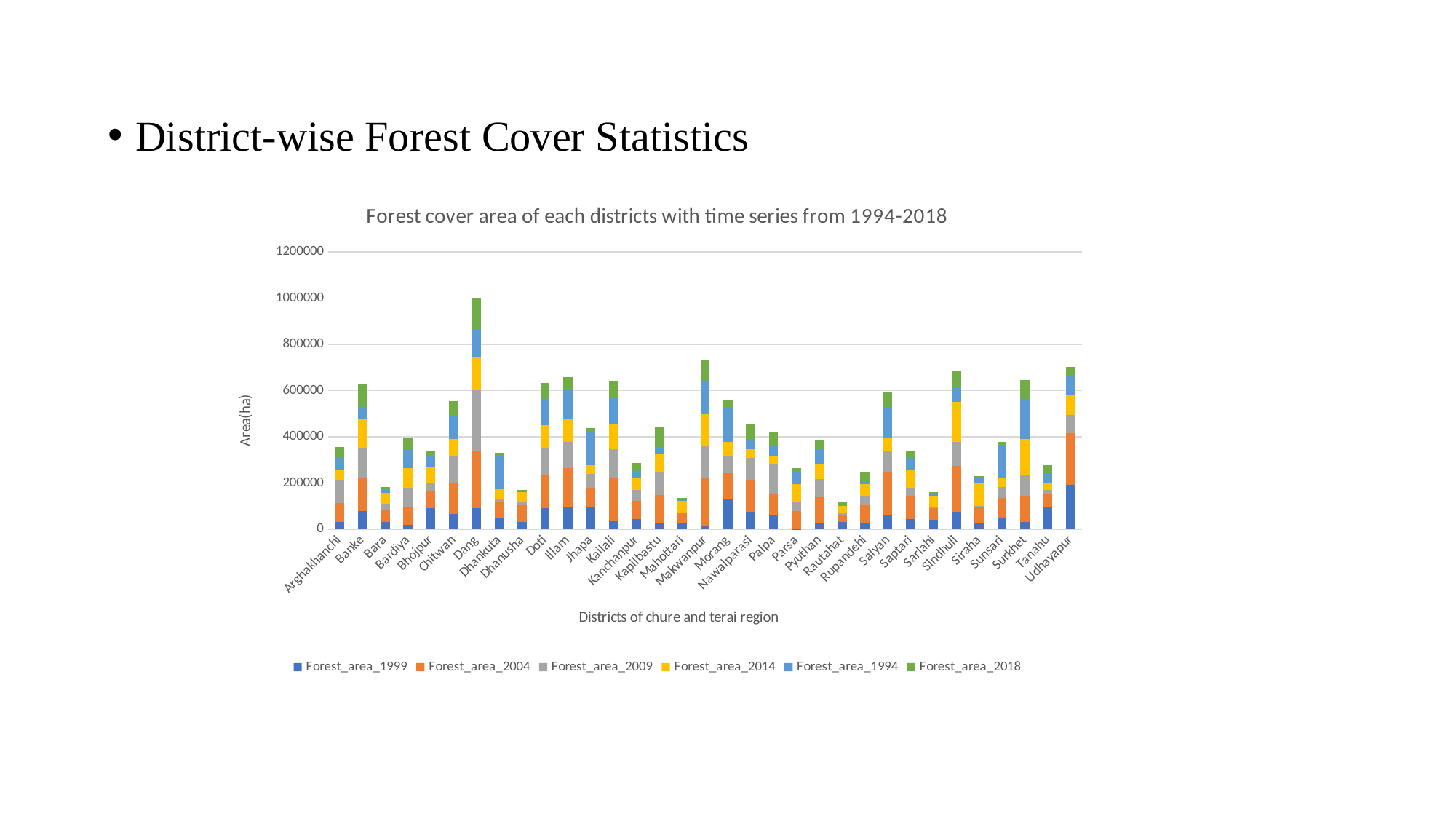
Which district has the highest total stacked bar? Dang Is the total stacked value for Dang greater or less than 800000? greater What kind of chart is shown on the slide? Stacked bar chart What is the label of the y axis? Area(ha) How many series does the legend list? 6 Which district has the lowest total stacked bar? Rautahat How many districts are shown on the x axis? 33 What is the title of the chart? Forest cover area of each districts with time series from 1994-2018 Is the total stacked value for Rautahat greater or less than 200000? less Is the total stacked value for Makwanpur greater or less than 600000? greater Which district has a larger total stacked bar, Banke or Bara? Banke Which district has a larger total stacked bar, Dang or Makwanpur? Dang